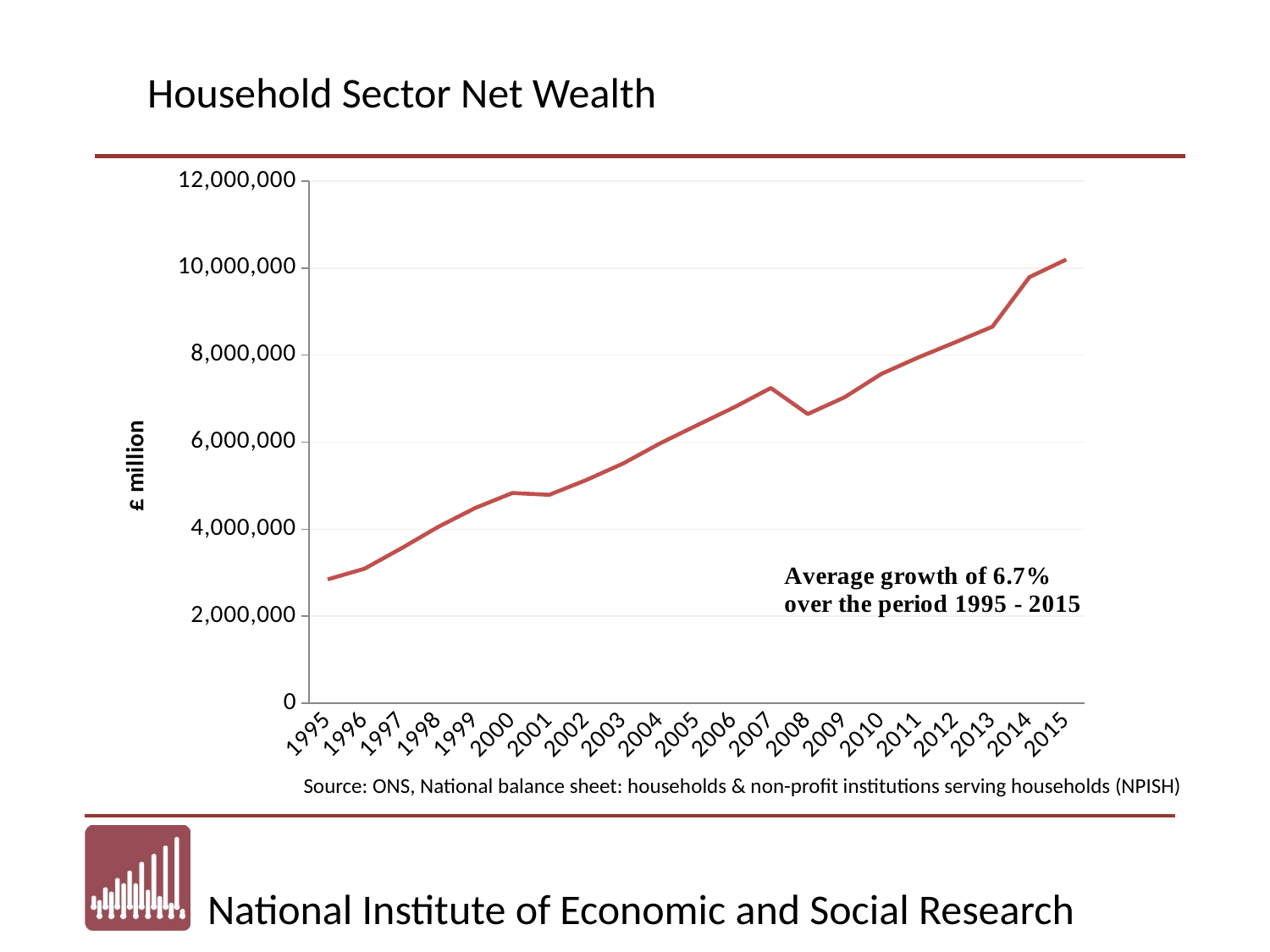
Which year has the highest household sector net wealth? 2015 Is the value for 2008 greater or less than 8,000,000? less Is the value for 2013 greater or less than 8,000,000? greater What average growth rate over 1995 - 2015 is stated on the chart? 6.7% Do the values generally rise or fall from 1995 to 2015? rise Is the value for 1995 greater or less than 4,000,000? less What is the label on the y axis? £ million Which year has the lowest household sector net wealth? 1995 What kind of chart is shown on the slide? line chart Which year has the larger value, 2007 or 2008? 2007 How many years are plotted along the x axis? 21